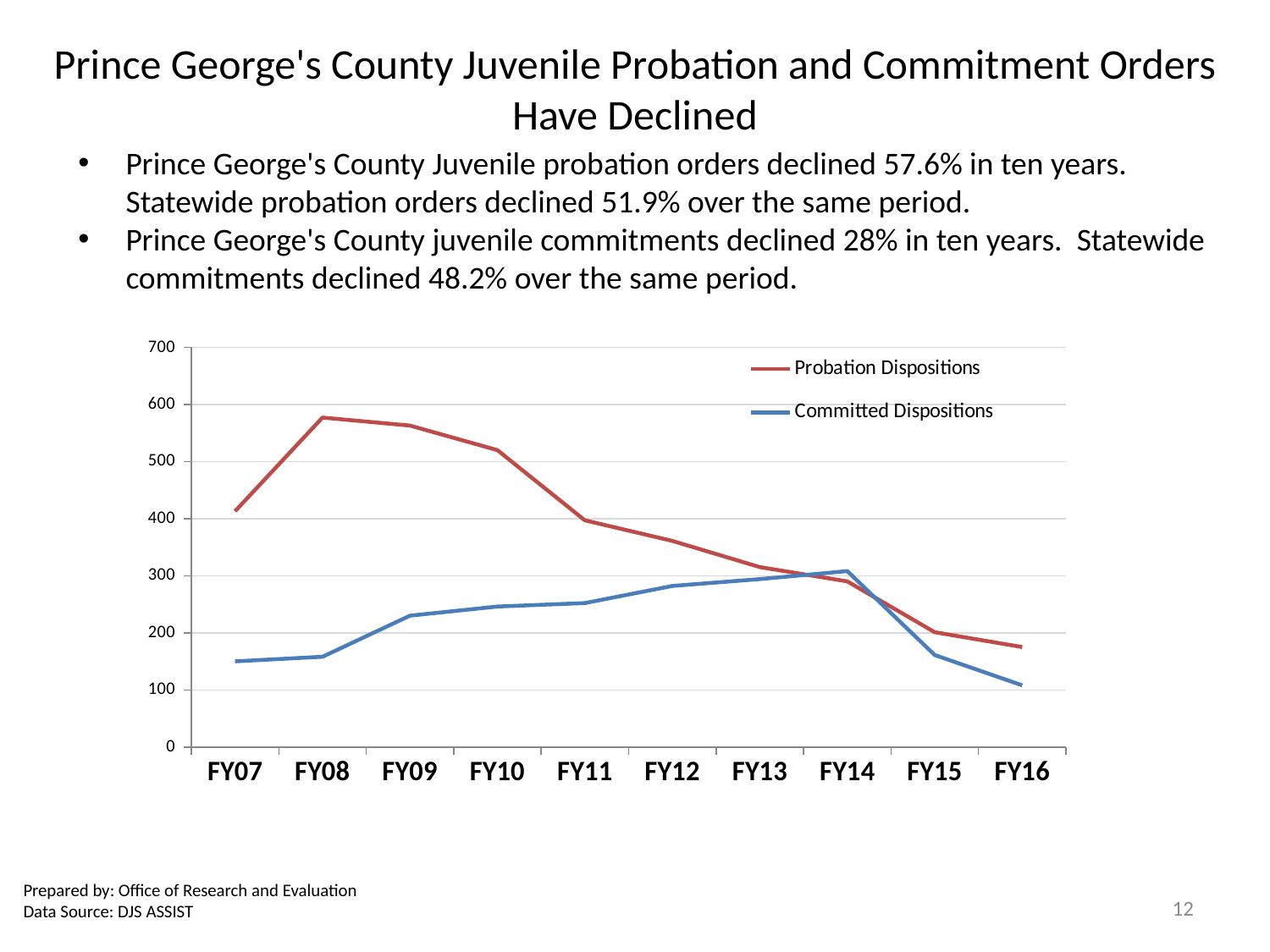
What kind of chart is shown on the slide? Line chart In which fiscal year do Committed Dispositions reach their highest value? FY14 Is the value for Probation Dispositions in FY08 greater or less than 500? greater In which fiscal year do Probation Dispositions reach their highest value? FY08 How many series does the chart legend list? 2 In FY14, which series has the larger value, Probation Dispositions or Committed Dispositions? Committed Dispositions Is the value for Committed Dispositions in FY07 greater or less than 200? less Do Probation Dispositions rise or fall from FY08 to FY16? Fall In which fiscal year are Committed Dispositions lowest? FY16 In which fiscal year are Probation Dispositions lowest? FY16 How many fiscal years are plotted along the x axis of the chart? 10 Which series is drawn in red on the chart? Probation Dispositions